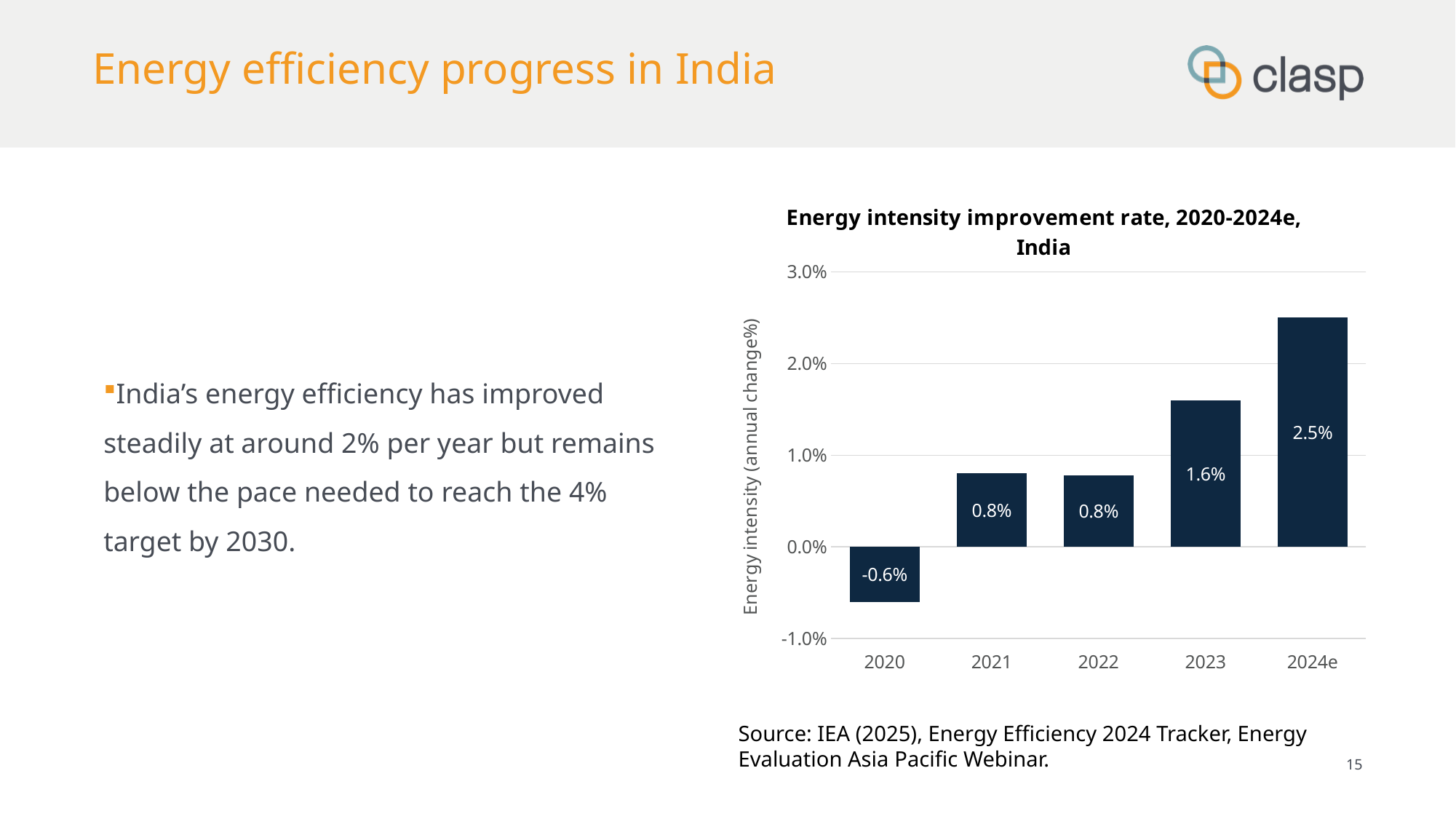
What is the energy intensity improvement rate for 2020? -0.6% Which year has the lowest energy intensity improvement rate? 2020 What is the energy intensity improvement rate for 2023? 1.6% What is the energy intensity improvement rate for 2024e? 2.5% Which year has the highest energy intensity improvement rate? 2024e Which year has a larger energy intensity improvement rate, 2021 or 2023? 2023 What kind of chart is shown on the slide? Bar chart Do the energy intensity improvement rates generally rise or fall from 2020 to 2024e? Rise What is the difference between the 2024e and 2023 energy intensity improvement rates? 0.9% Is the value for 2024e greater or less than 2.0%? greater What is the title of the chart? Energy intensity improvement rate, 2020-2024e, India How many years are shown on the x axis of the chart? 5